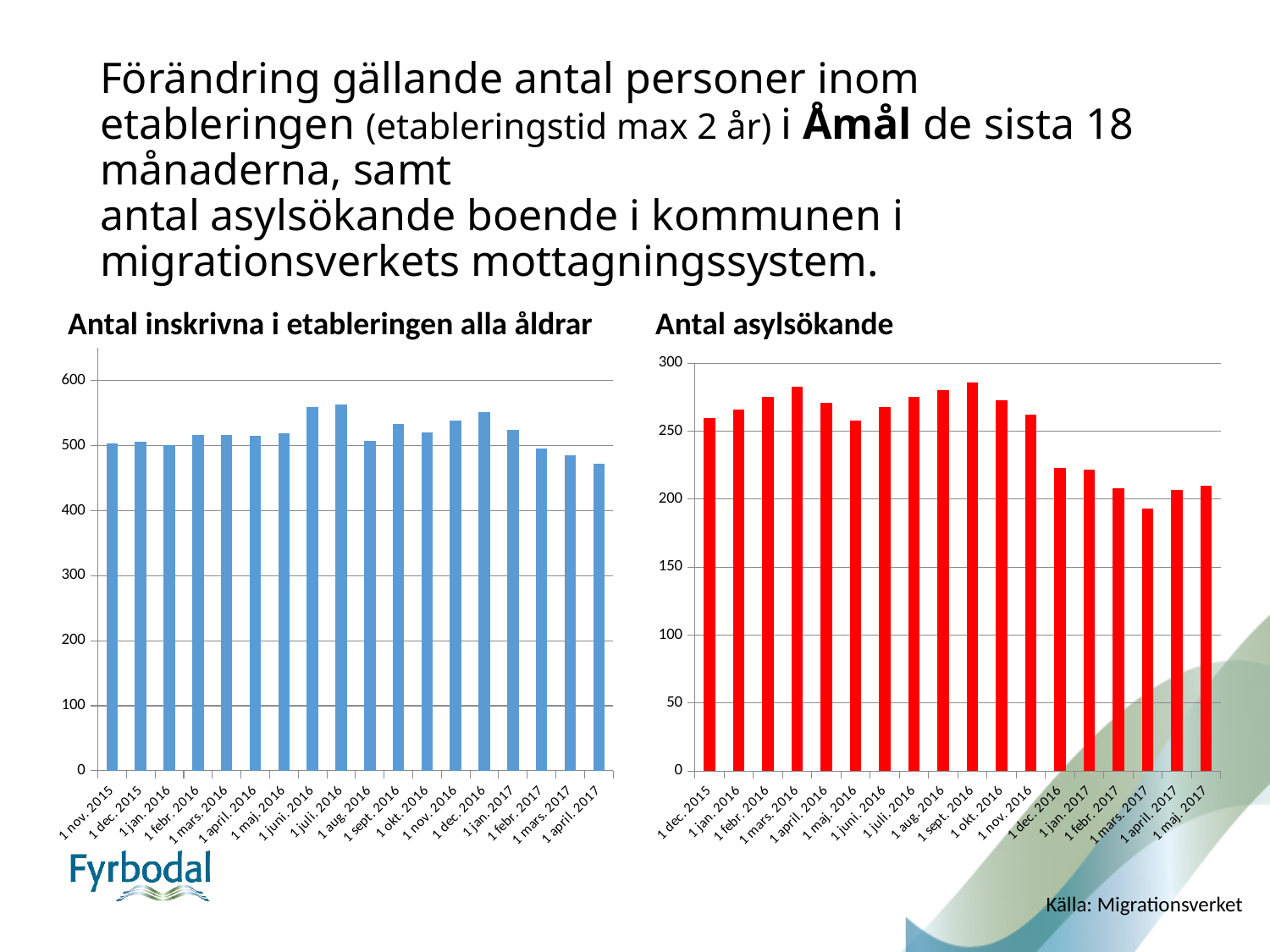
In the right chart "Antal asylsökande", which is larger: the value for 1 dec. 2015 or the value for 1 dec. 2016? 1 dec. 2015 How many bars (months) are plotted in the right chart "Antal asylsökande"? 18 What colour are the bars in the right chart "Antal asylsökande"? red In the right chart "Antal asylsökande", is the value for 1 sept. 2016 greater or less than 250? greater How many bars (months) are plotted in the left chart "Antal inskrivna i etableringen alla åldrar"? 18 In the right chart "Antal asylsökande", is the value for 1 mars 2017 greater or less than 200? less What kind of chart is the left chart titled "Antal inskrivna i etableringen alla åldrar"? bar chart In the left chart "Antal inskrivna i etableringen alla åldrar", which month has the lowest value? 1 april 2017 In the right chart "Antal asylsökande", do the values overall rise or fall from 1 dec. 2015 to 1 maj 2017? fall In the left chart "Antal inskrivna i etableringen alla åldrar", is the value for 1 juli 2016 greater or less than 500? greater In the right chart "Antal asylsökande", which month has the lowest value? 1 mars 2017